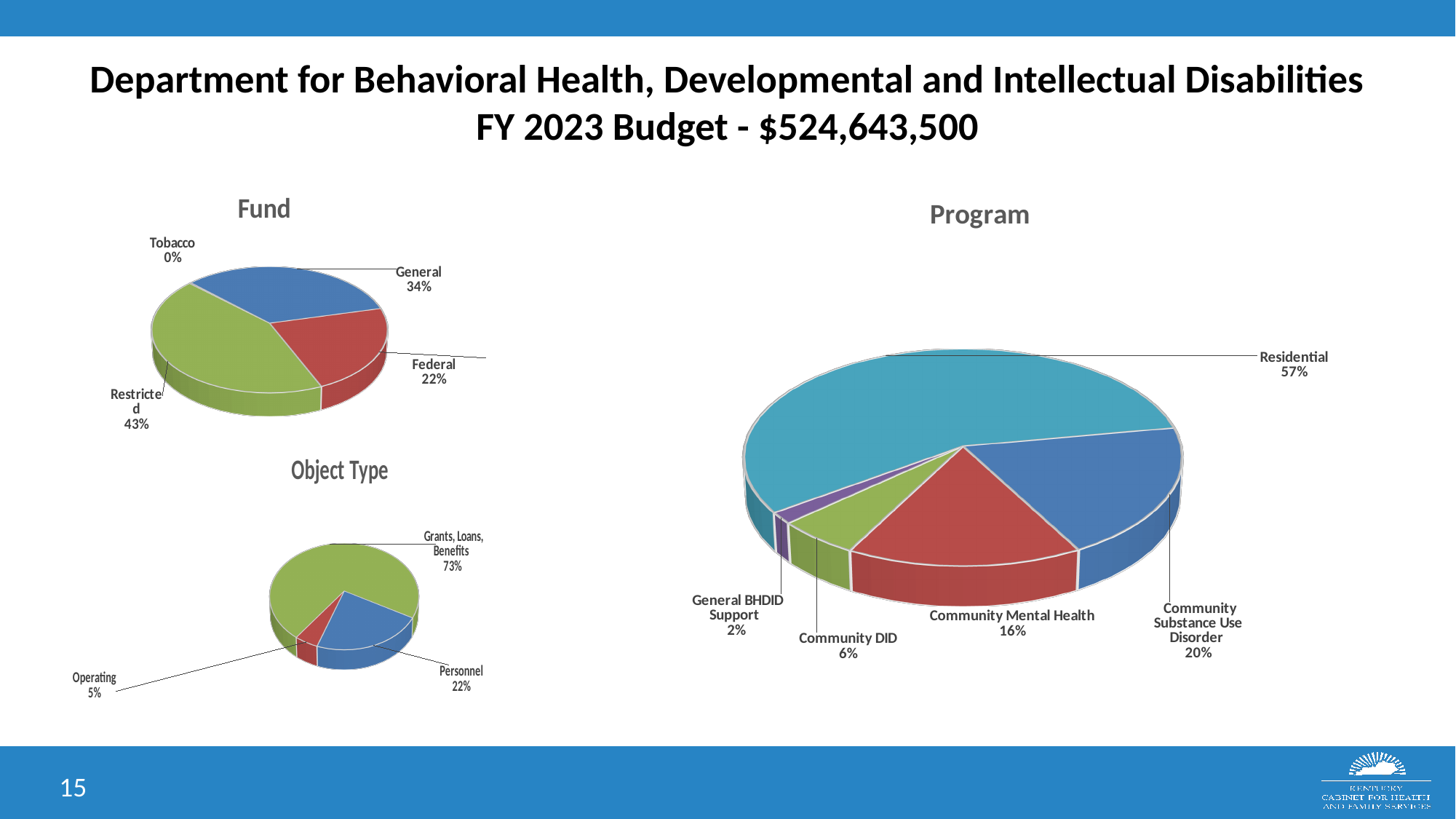
In the Fund chart, which fund source has the largest share? Restricted What kind of chart is the Program chart? Pie chart In the Program chart, what share is Community Substance Use Disorder? 20% In the Object Type chart, which is larger, Personnel or Operating? Personnel In the Object Type chart, what share is Grants, Loans, Benefits? 73% In the Program chart, what is the difference between the Community Mental Health and Community DID shares? 10% In the Fund chart, what share of the budget is Federal? 22% In the Fund chart, what share of the budget is Restricted? 43% How many categories does the Object Type chart show? 3 In the Program chart, which program has the largest share? Residential In the Fund chart, what is the difference between the General and Federal shares? 12% In the Fund chart, which fund source has the smallest share? Tobacco